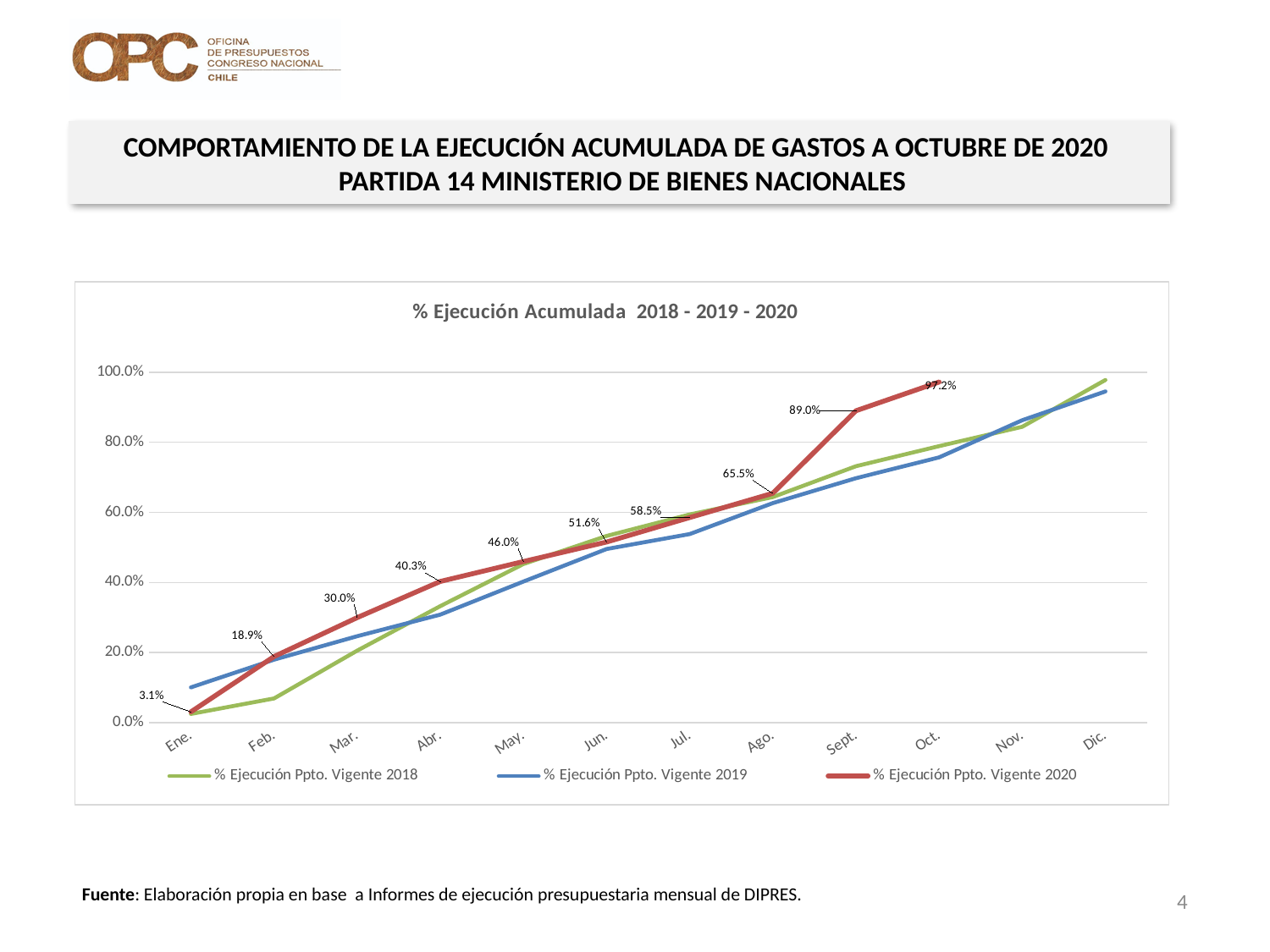
What kind of chart is shown? Line chart What is the value for % Ejecución Ppto. Vigente 2020 in Ene.? 3.1% What is the title of the chart? % Ejecución Acumulada 2018 - 2019 - 2020 Is the value for % Ejecución Ppto. Vigente 2019 in Ene. greater or less than 20.0%? less What is the value for % Ejecución Ppto. Vigente 2020 in Abr.? 40.3% What is the value for % Ejecución Ppto. Vigente 2020 in Oct.? 97.2% What is the difference between the % Ejecución Ppto. Vigente 2020 values for Sept. and Ago.? 23.5% How many months are shown on the x axis? 12 In which month does % Ejecución Ppto. Vigente 2020 reach its highest value? Oct. How many series does the legend list? 3 Do the values for % Ejecución Ppto. Vigente 2020 rise or fall from Ene. to Oct.? Rise In which month is % Ejecución Ppto. Vigente 2020 lowest? Ene.